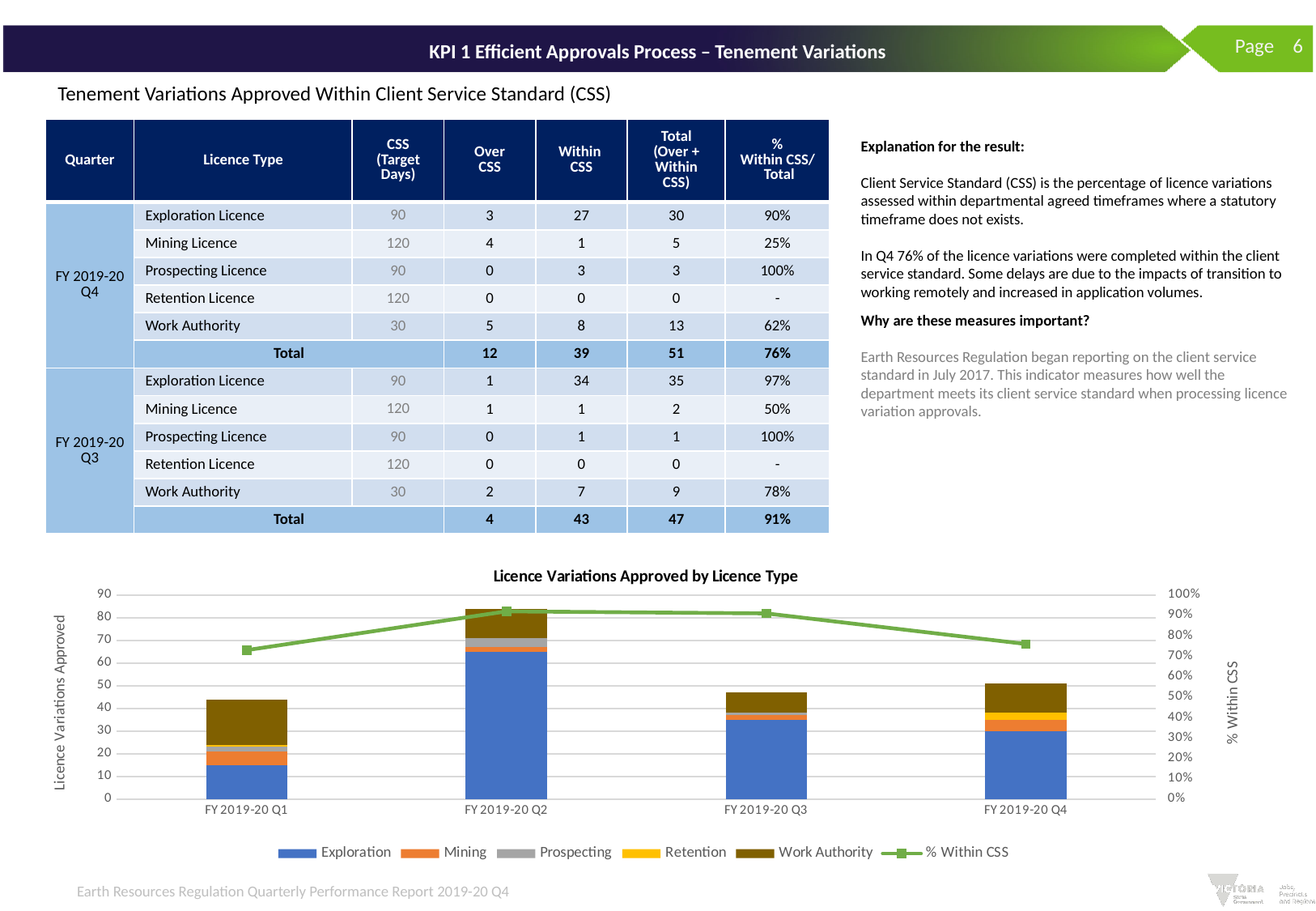
Does the % Within CSS line rise or fall from FY 2019-20 Q3 to FY 2019-20 Q4? Fall How many series does the legend of the chart list? 6 Which quarter has the tallest stacked bar in the chart? FY 2019-20 Q2 Which is larger: the total stacked bar for FY 2019-20 Q2 or for FY 2019-20 Q3? FY 2019-20 Q2 What is the title of the chart on the slide? Licence Variations Approved by Licence Type How many quarters are shown on the x axis of the chart? 4 Is the total stacked bar for FY 2019-20 Q2 greater or less than 80? greater Is the total stacked bar for FY 2019-20 Q1 greater or less than 50? less Which is larger in the chart: the Exploration segment for FY 2019-20 Q2 or for FY 2019-20 Q4? FY 2019-20 Q2 What is the label of the right-hand vertical axis of the chart? % Within CSS What kind of chart is 'Licence Variations Approved by Licence Type'? Stacked bar chart with a line Is the % Within CSS value for FY 2019-20 Q1 greater or less than 80%? less